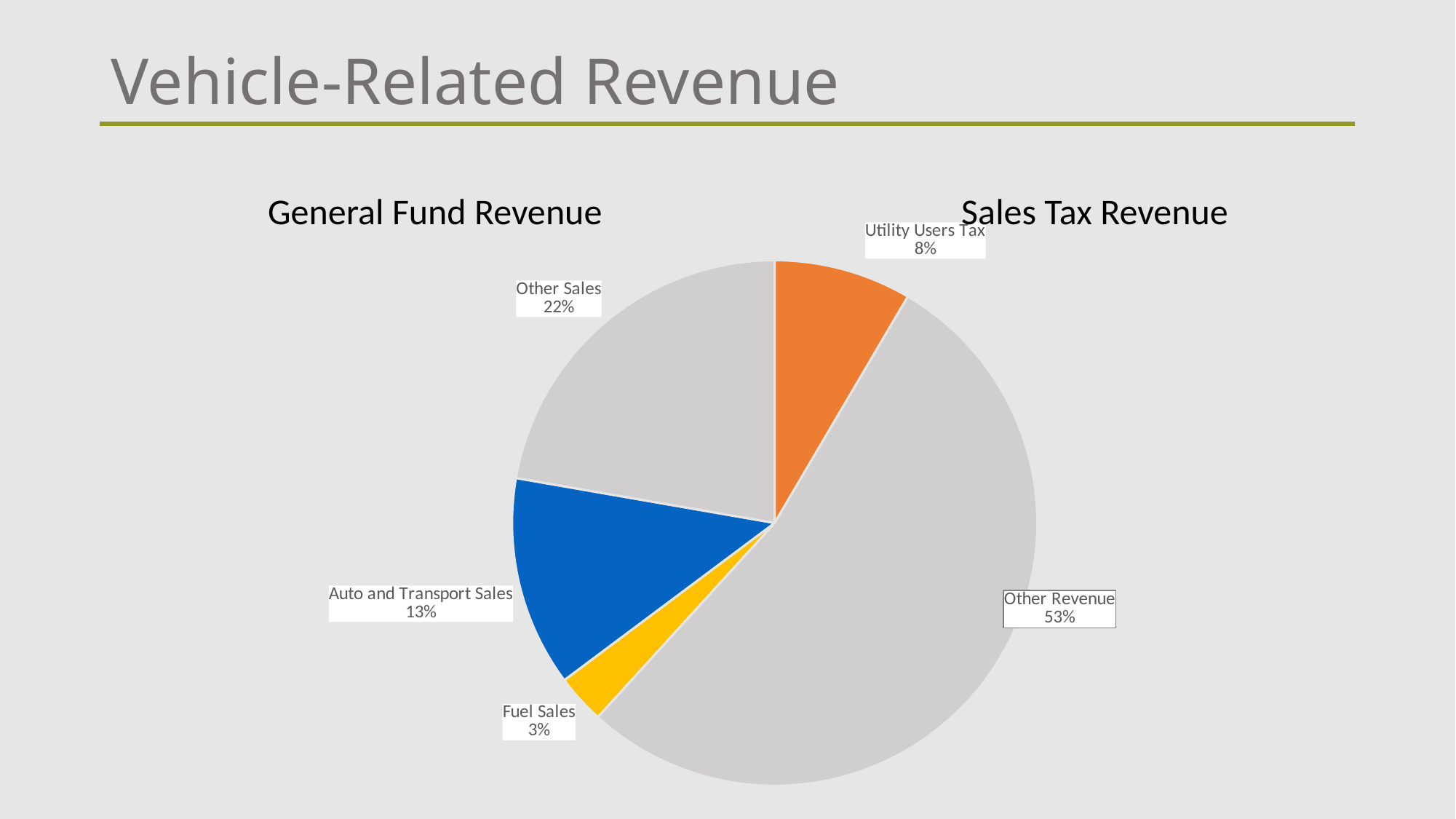
How many slices does the pie chart have? 5 Which is larger, Utility Users Tax or Auto and Transport Sales? Auto and Transport Sales What share of the pie is labelled Other Revenue? 53% What kind of chart is shown on the slide? pie chart Which slice of the pie is the largest? Other Revenue What is the title of the slide? Vehicle-Related Revenue What percentage is shown for Fuel Sales? 3% What is the difference in percentage points between Other Sales and Auto and Transport Sales? 9 What percentage is shown for Auto and Transport Sales? 13% Which slice of the pie is the smallest? Fuel Sales What percentage is shown for Utility Users Tax? 8% What percentage is shown for Other Sales? 22%